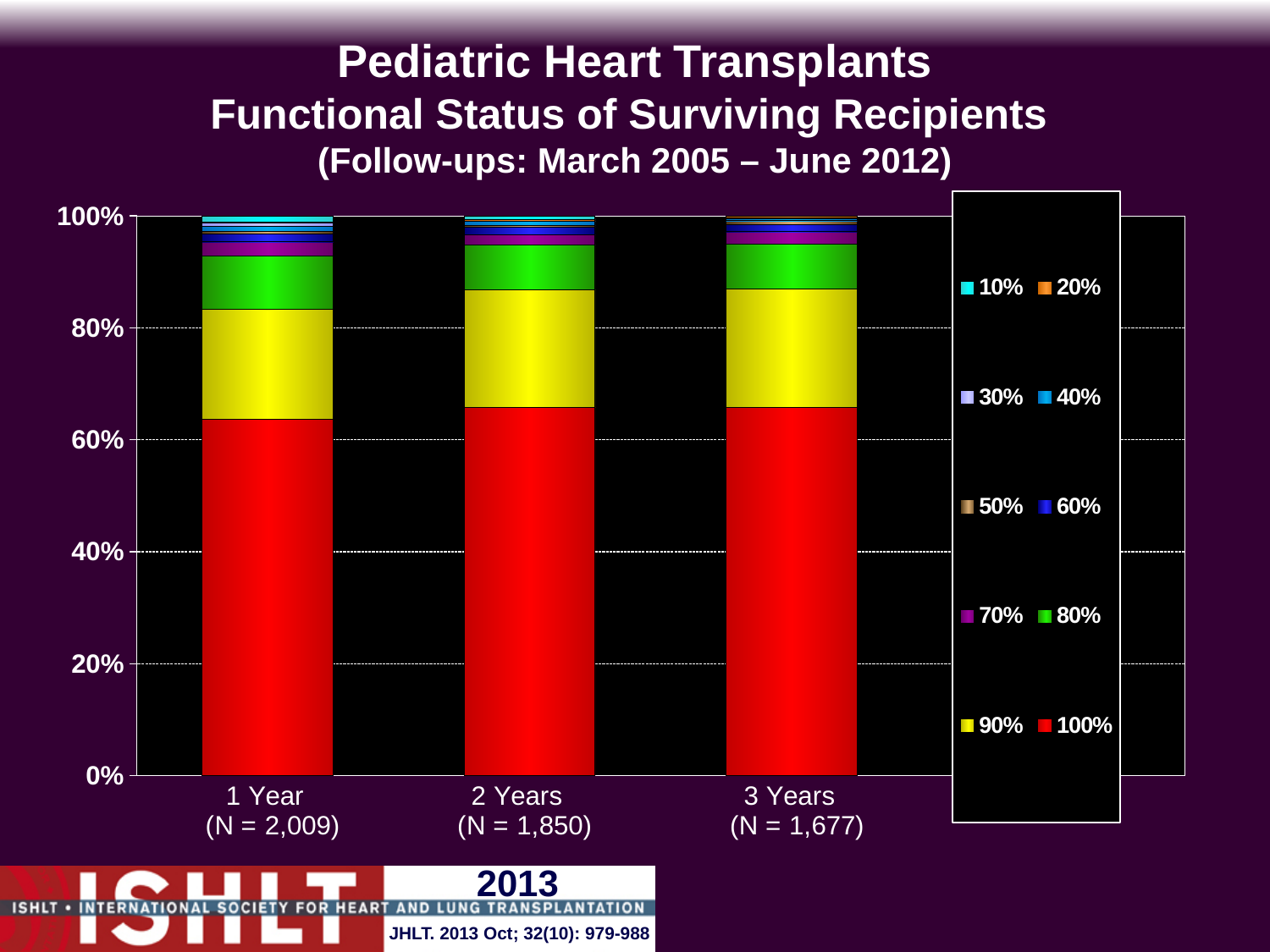
Which functional status series makes up the largest share of the 1 Year bar? 100% Which functional status series makes up the largest share of the 3 Years bar? 100% How many series does the legend list? 10 What kind of chart is shown on the slide? Stacked bar chart Is the share of the 100% functional status segment in the 2 Years bar greater or less than 80%? less Is the share of the 80% functional status segment in the 1 Year bar greater or less than 20%? less Which series is shown in red in the legend? 100% What is the N value shown for the 2 Years category? N = 1,850 Is the share of the 100% functional status segment in the 1 Year bar greater or less than 60%? greater What follow-up period does the chart title state? March 2005 – June 2012 How many follow-up categories are shown on the x axis? 3